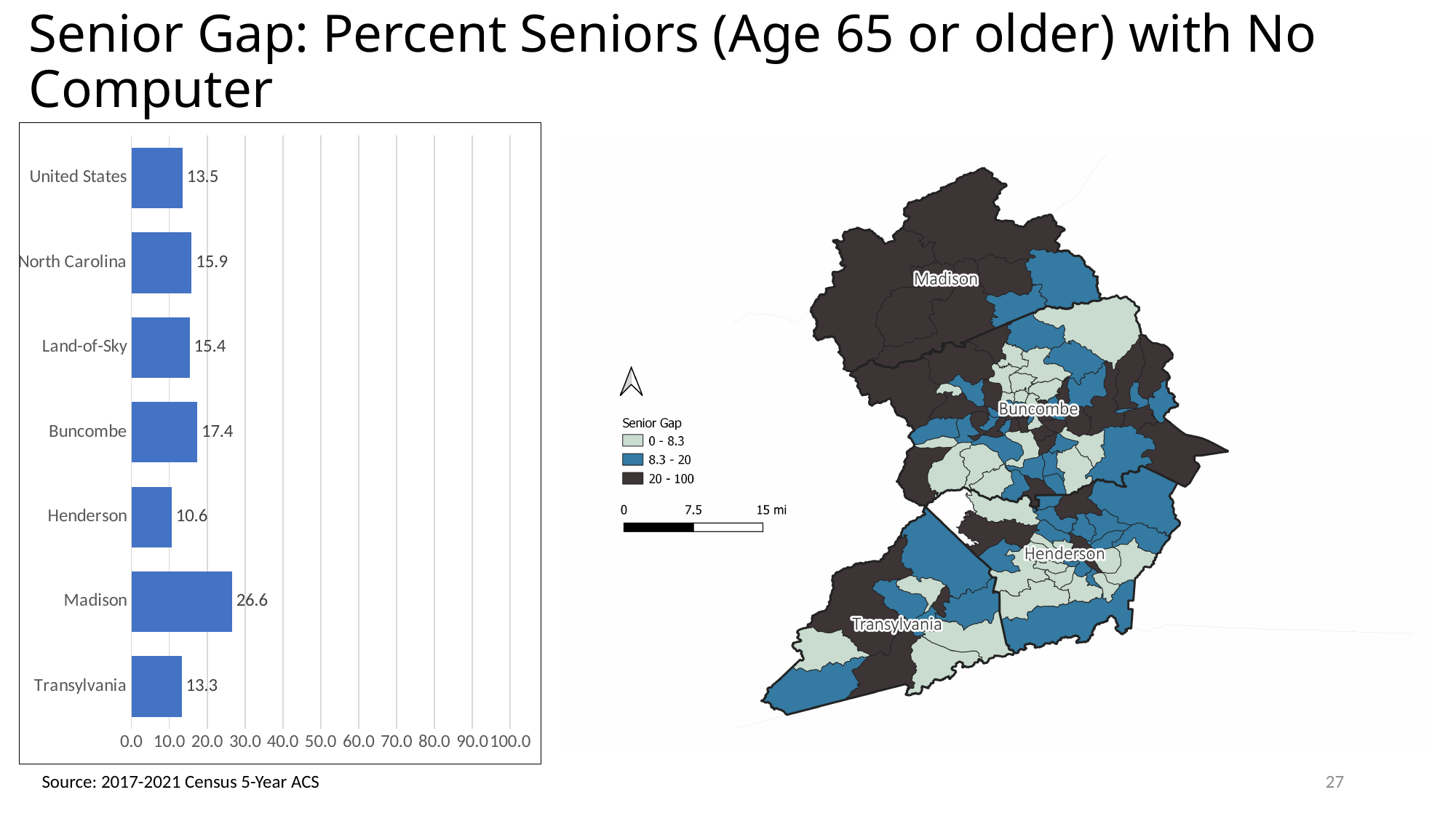
In the bar chart, what is the difference between the values for Madison and Henderson? 16.0 How many categories are shown in the bar chart? 7 In the bar chart, what is the value for Henderson? 10.6 In the bar chart, what is the value for the United States? 13.5 In the bar chart, is the value for Madison greater or less than 20.0? greater In the bar chart, which category has the highest value? Madison In the bar chart, what is the value for Land-of-Sky? 15.4 In the bar chart, what is the value for Madison? 26.6 In the bar chart, which category has the lowest value? Henderson In the bar chart, which is larger, the value for Buncombe or the value for North Carolina? Buncombe What kind of chart is shown on the left of the slide? bar chart In the bar chart, what is the difference between the values for North Carolina and the United States? 2.4